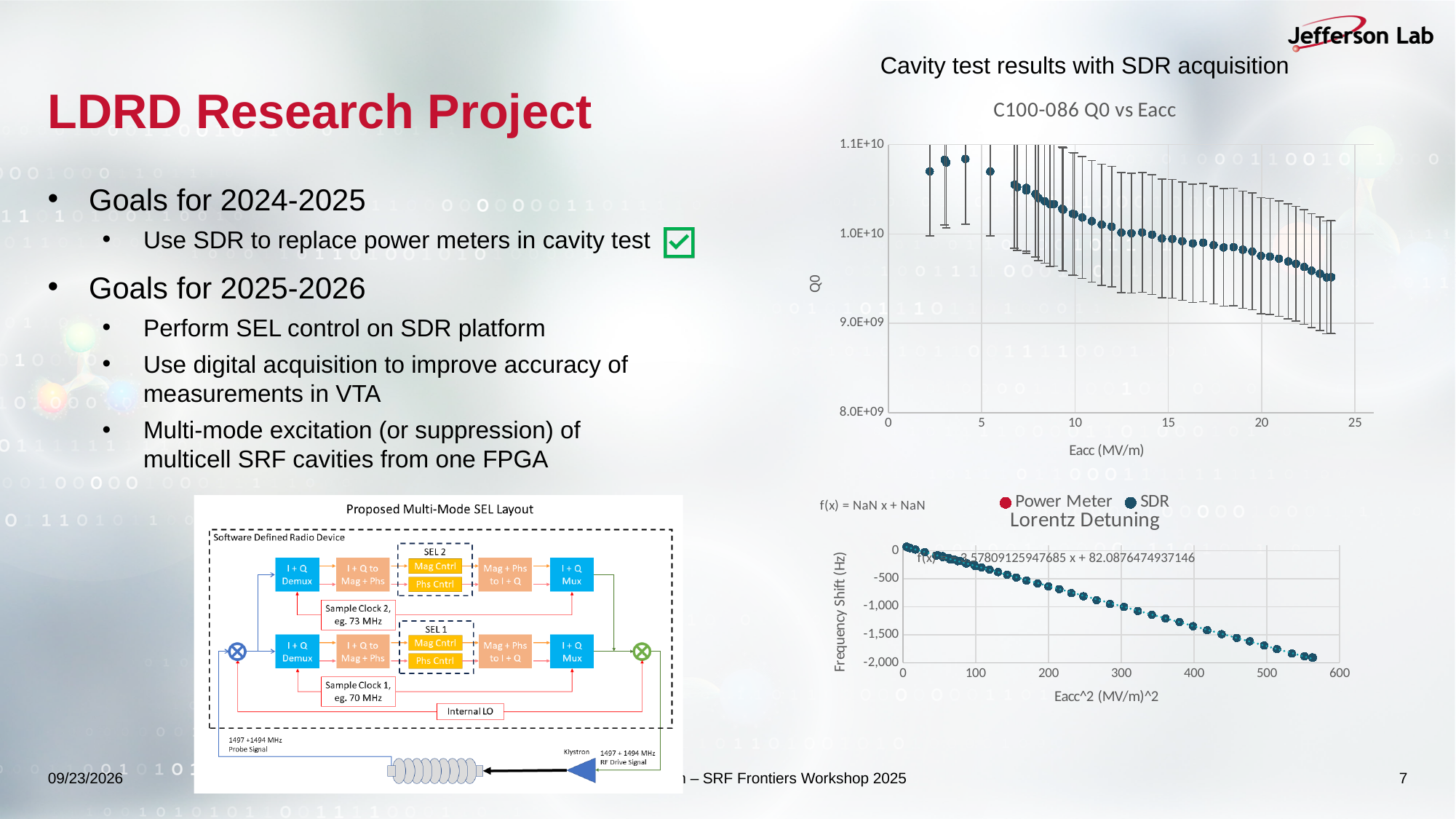
What is the x-axis label of the "C100-086 Q0 vs Eacc" chart? Eacc (MV/m) What kind of chart is the "C100-086 Q0 vs Eacc" chart? scatter chart In the "C100-086 Q0 vs Eacc" chart, is the Q0 value at the highest Eacc point (around 23.5 MV/m) greater or less than 1.0E+10? less In the "C100-086 Q0 vs Eacc" chart, does Q0 rise or fall as Eacc increases? fall In the "Lorentz Detuning" chart, does the frequency shift rise or fall as Eacc^2 increases? fall In the "Lorentz Detuning" chart, is the frequency shift at Eacc^2 of about 100 greater or less than -500 Hz? greater What kind of chart is the "Lorentz Detuning" chart? scatter chart In the "C100-086 Q0 vs Eacc" chart, is the Q0 value at the lowest Eacc point (around 2 MV/m) greater or less than 1.0E+10? greater